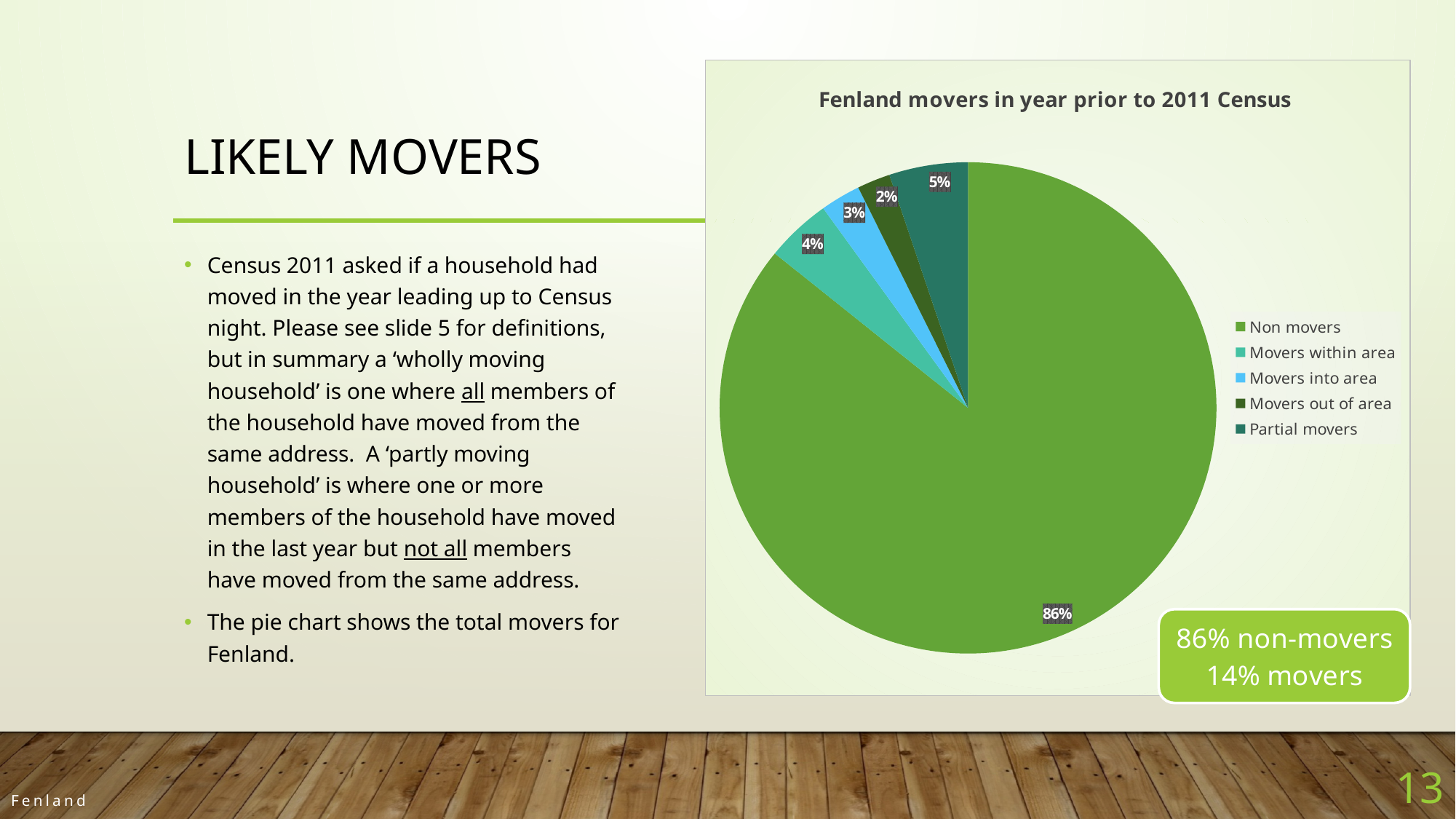
What is the title of the chart? Fenland movers in year prior to 2011 Census What percentage of the pie is Movers into area? 3% Which category has the largest share of the pie? Non movers Which is larger, Partial movers or Movers within area? Partial movers What type of chart is shown on the slide? Pie chart Which category has the smallest share of the pie? Movers out of area What percentage of the pie is Partial movers? 5% How many categories does the legend list? 5 What percentage of the pie is Non movers? 86% What is the difference in percentage points between Non movers and Partial movers? 81 What percentage of the pie is Movers within area? 4% What percentage of the pie is Movers out of area? 2%